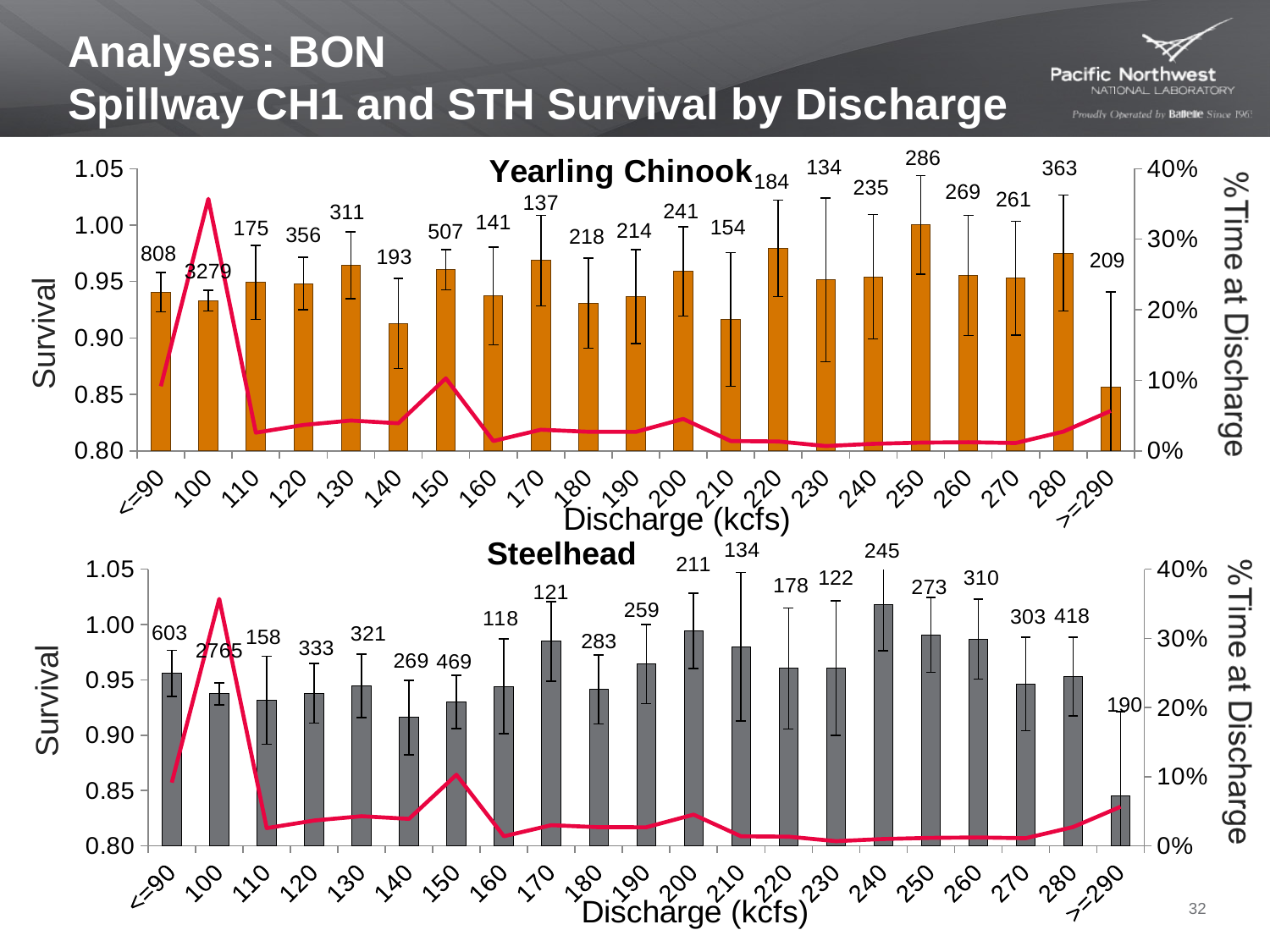
In the Yearling Chinook chart, is the survival bar for 140 or for 150 taller? 150 What is the title of the top chart? Yearling Chinook In the Steelhead chart, which discharge category has the highest survival bar? 240 What kind of chart is the Yearling Chinook chart? combination bar and line chart In the Steelhead chart, what is the label on the x axis? Discharge (kcfs) In the Yearling Chinook chart, which discharge category has the lowest survival bar? >=290 In the Yearling Chinook chart, what number is printed above the bar for 100 kcfs? 3279 In the Steelhead chart, is the survival bar for <=90 or for 100 taller? <=90 How many discharge categories are shown on the x axis of the Steelhead chart? 21 In the Steelhead chart, is the survival value for 240 greater or less than 1.00? greater In the Steelhead chart, what number is printed above the bar for >=290? 190 In the Yearling Chinook chart, is the survival value for >=290 greater or less than 0.90? less